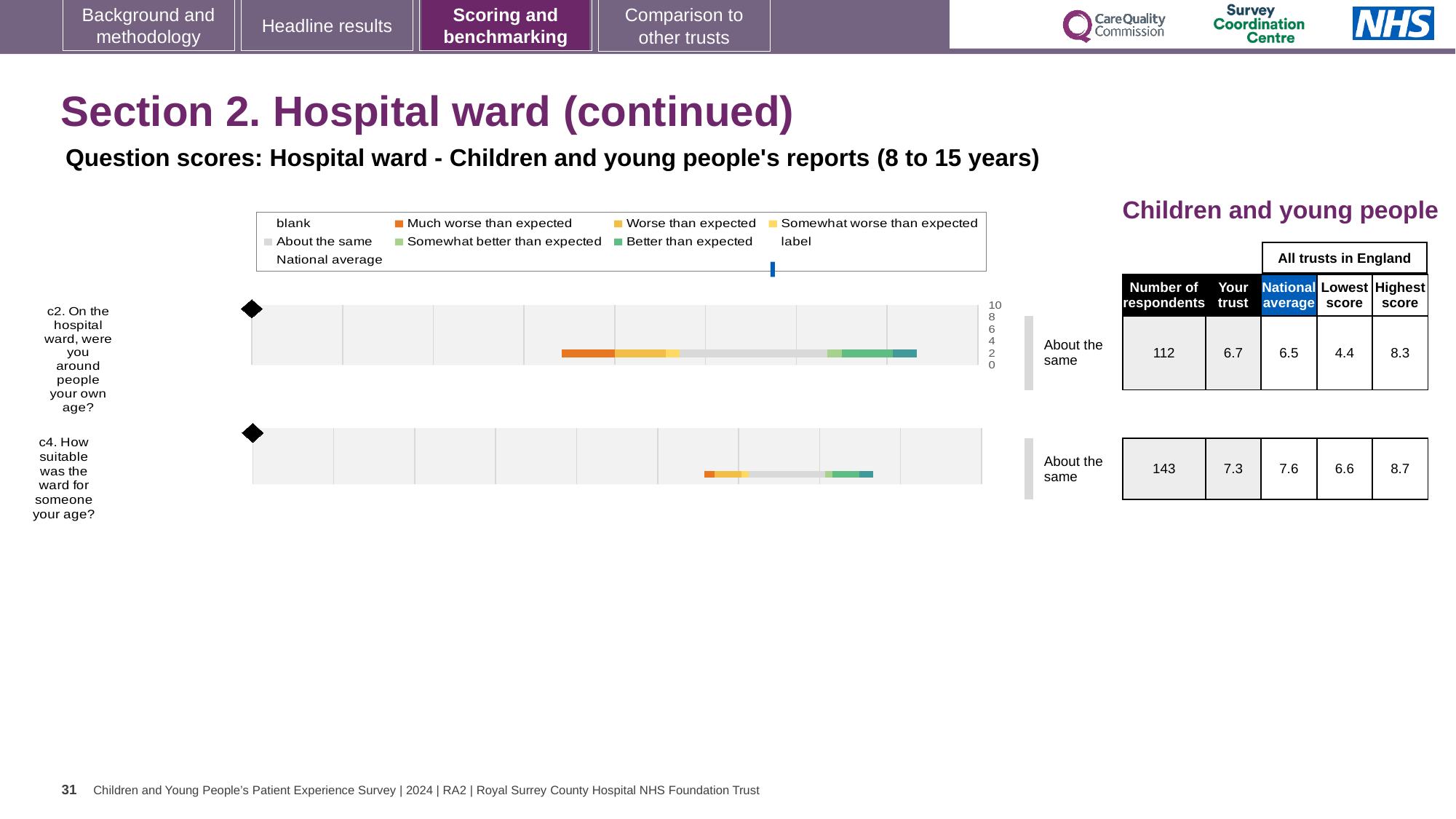
What is the 'Your trust' score for question c4 (How suitable was the ward for someone your age?)? 7.3 What is the 'Your trust' score for question c2 (On the hospital ward, were you around people your own age?)? 6.7 What kind of chart is used to show the question scores? Bar chart What is the highest score among all trusts in England for question c4? 8.7 What is the national average score for question c4? 7.6 How many survey questions are plotted on this slide? 2 What is the difference between the highest and lowest scores for question c4? 2.1 What is the national average score for question c2? 6.5 How many respondents answered question c4? 143 What benchmark category is shown for question c2? About the same Which question has the higher 'Your trust' score, c2 or c4? c4 What is the lowest score among all trusts in England for question c2? 4.4